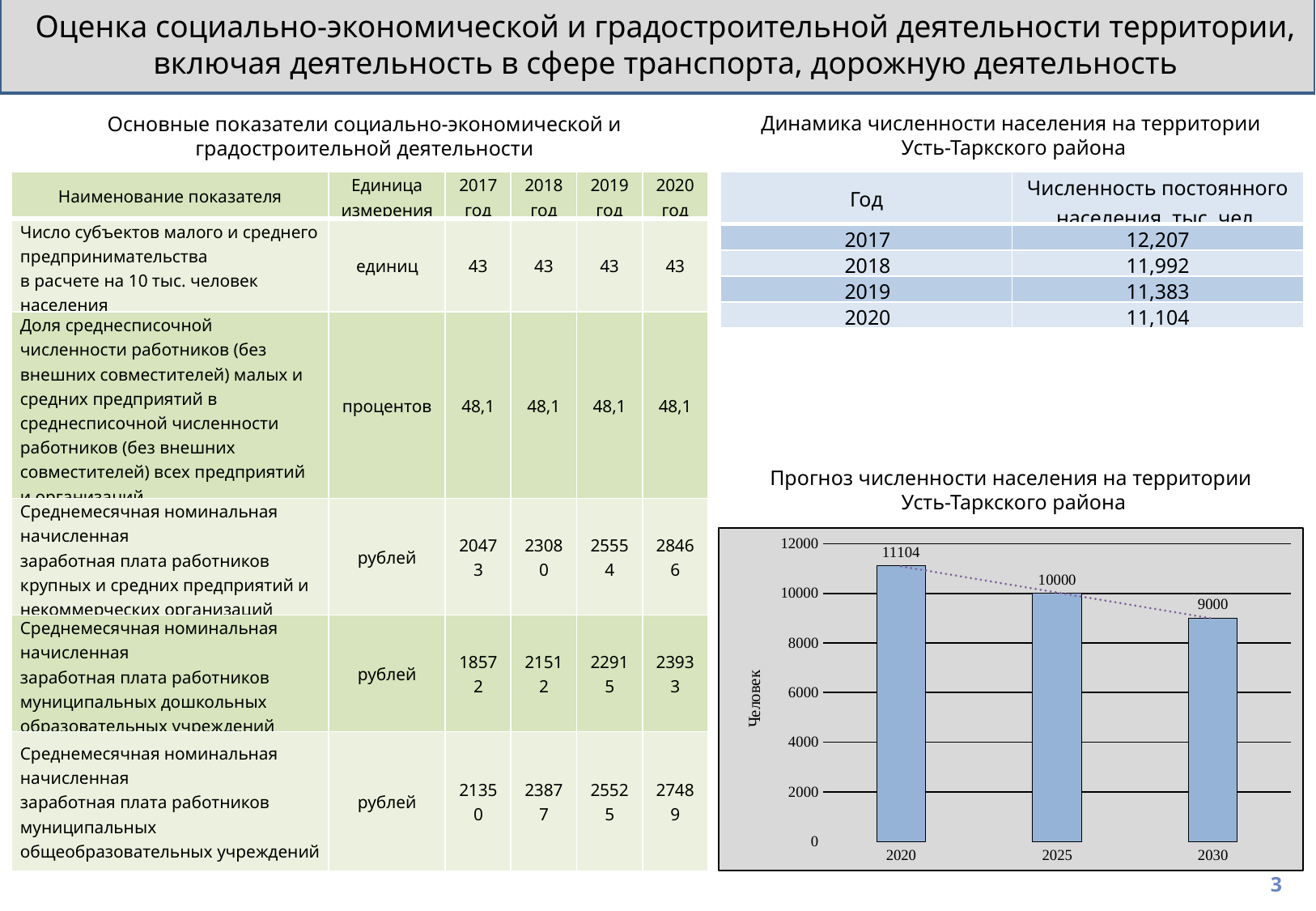
What is the forecast population value shown for 2030 in the chart? 9000 What is the forecast population value shown for 2025 in the chart? 10000 How many years (bars) are shown in the population forecast chart? 3 Do the values in the population forecast chart rise or fall from 2020 to 2030? fall What is the difference between the 2020 and 2030 values in the population forecast chart? 2104 What type of chart is used for the population forecast? bar chart Is the value for 2030 in the population forecast chart greater or less than 10000? less What is the difference between the 2025 and 2030 values in the population forecast chart? 1000 What is the forecast population value shown for 2020 in the chart? 11104 Which year has the highest value in the population forecast chart? 2020 Which is larger in the population forecast chart, the value for 2020 or the value for 2025? 2020 Which year has the lowest value in the population forecast chart? 2030